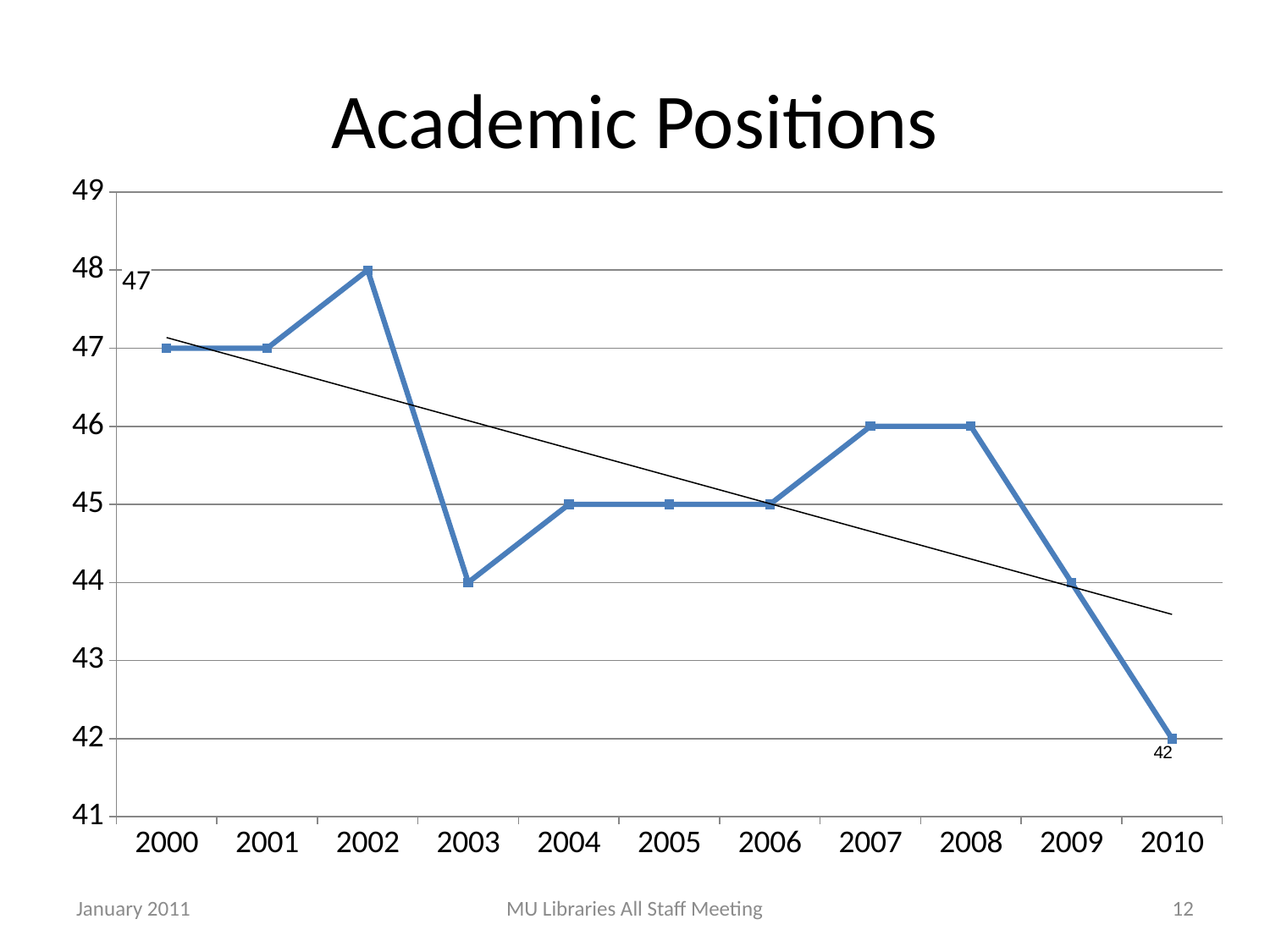
What is the value for 2003? 44 Which year has the lowest value? 2010 What kind of chart is this? line chart Is the value for 2009 greater or less than 45? less Which is larger, the value for 2007 or the value for 2009? 2007 What is the difference between the value for 2000 and the value for 2010? 5 Which year has the highest value? 2002 How many years are plotted on the x axis? 11 What is the value for 2000? 47 What is the value for 2010? 42 What is the title of the chart? Academic Positions What is the value for 2002? 48